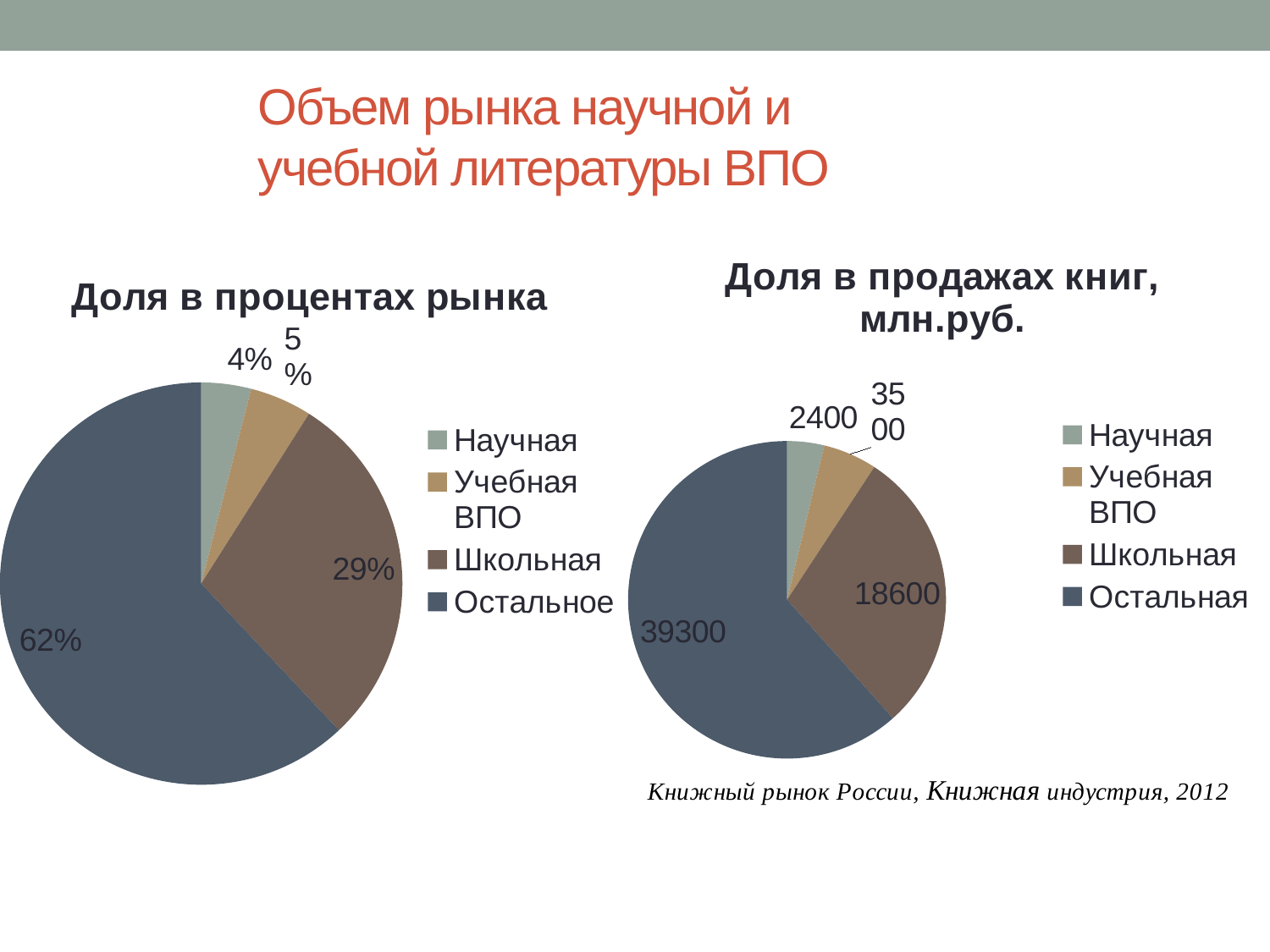
What type of chart is 'Доля в процентах рынка'? pie chart What is the title of the chart on the right side of the slide? Доля в продажах книг, млн.руб. In the chart 'Доля в процентах рынка', what is the value for Школьная? 29% In the chart 'Доля в продажах книг, млн.руб.', what is the value for Остальная? 39300 In the chart 'Доля в продажах книг, млн.руб.', which is larger, Школьная or Учебная ВПО? Школьная In the chart 'Доля в продажах книг, млн.руб.', what is the difference between Школьная and Научная? 16200 In the chart 'Доля в продажах книг, млн.руб.', what is the value for Учебная ВПО? 3500 In the chart 'Доля в процентах рынка', what is the value for Научная? 4% In the chart 'Доля в процентах рынка', which category has the largest share? Остальное In the chart 'Доля в продажах книг, млн.руб.', which category has the smallest value? Научная In the chart 'Доля в процентах рынка', which category has the smallest share? Научная In the chart 'Доля в процентах рынка', how many categories does the legend list? 4